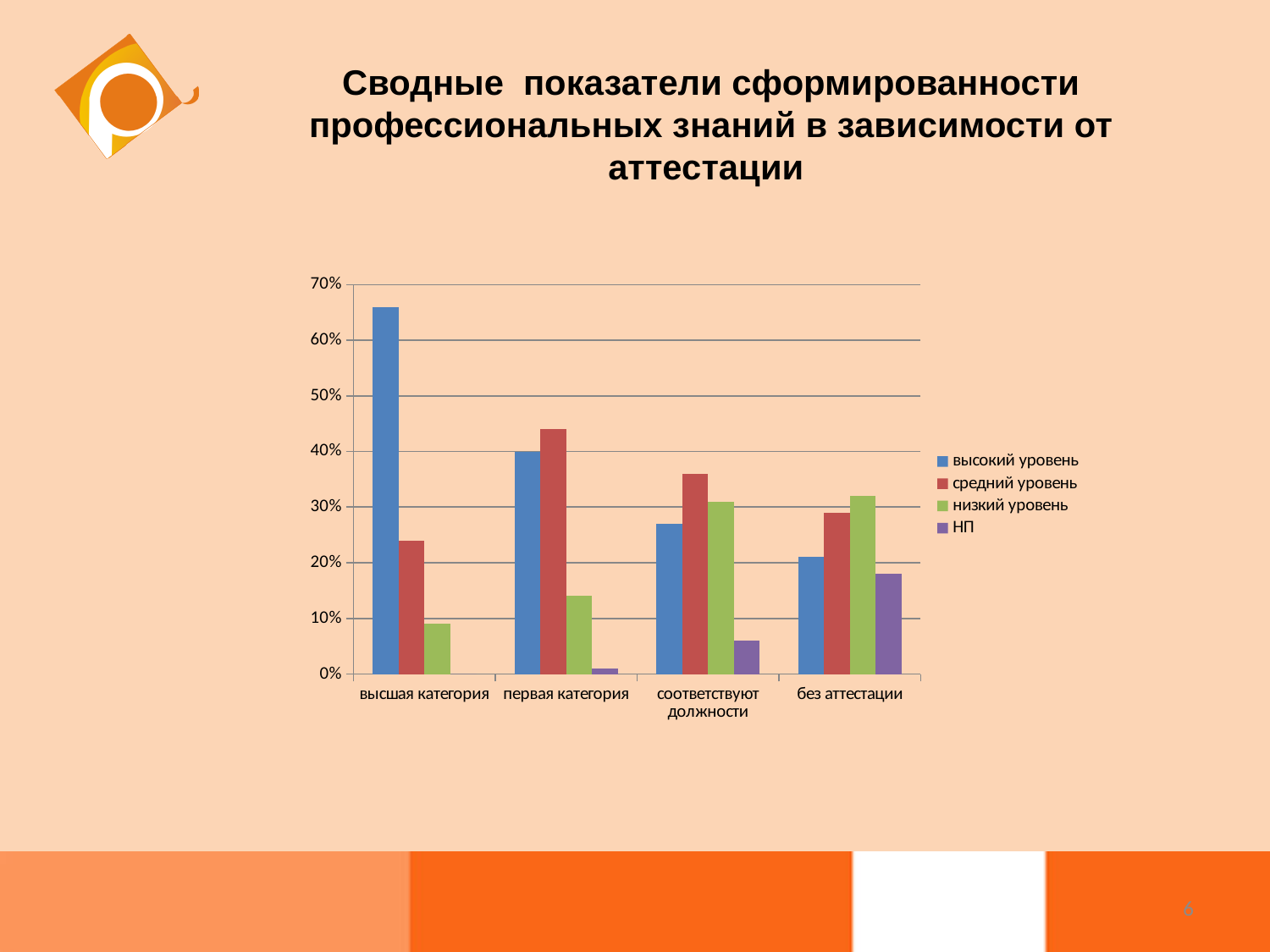
How many categories are shown on the x axis? 4 Which category has the highest value for НП? без аттестации Which category has the lowest value for высокий уровень? без аттестации Which is larger in первая категория: высокий уровень or средний уровень? средний уровень Does the value for высокий уровень rise or fall across the categories from left to right? fall Is the value for средний уровень in соответствуют должности greater or less than 30%? greater Which category has the highest value for высокий уровень? высшая категория Is the value for низкий уровень in высшая категория greater or less than 10%? less How many series does the legend list? 4 What kind of chart is shown on the slide? bar chart Is the value for высокий уровень in высшая категория greater or less than 60%? greater What colour represents низкий уровень in the legend? green